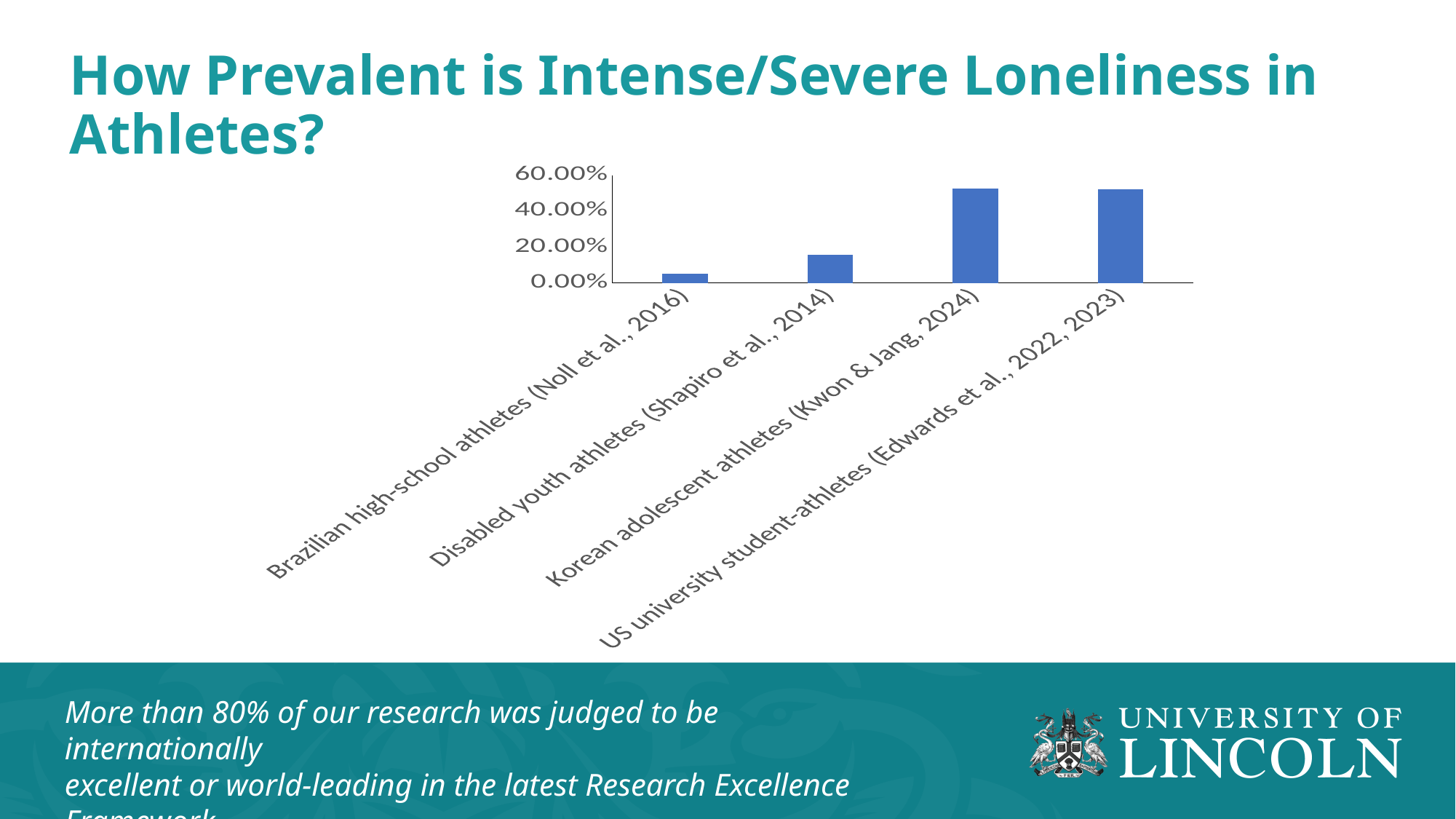
How many categories (athlete groups) are plotted in the chart? 4 Is the value for Korean adolescent athletes (Kwon & Jang, 2024) greater or less than 40.00%? greater What is the highest tick value shown on the chart's vertical axis? 60.00% What kind of chart is shown on the slide? bar chart What colour are the bars in the chart? blue Which is larger: the value for Korean adolescent athletes (Kwon & Jang, 2024) or for Disabled youth athletes (Shapiro et al., 2014)? Korean adolescent athletes (Kwon & Jang, 2024) Is the value for Disabled youth athletes (Shapiro et al., 2014) greater or less than 20.00%? less Is the value for Brazilian high-school athletes (Noll et al., 2016) greater or less than 20.00%? less Which is larger: the value for Disabled youth athletes (Shapiro et al., 2014) or for Brazilian high-school athletes (Noll et al., 2016)? Disabled youth athletes (Shapiro et al., 2014) Do the bar values generally rise or fall from left to right along the x axis? rise Which category has the lowest value in the chart? Brazilian high-school athletes (Noll et al., 2016)